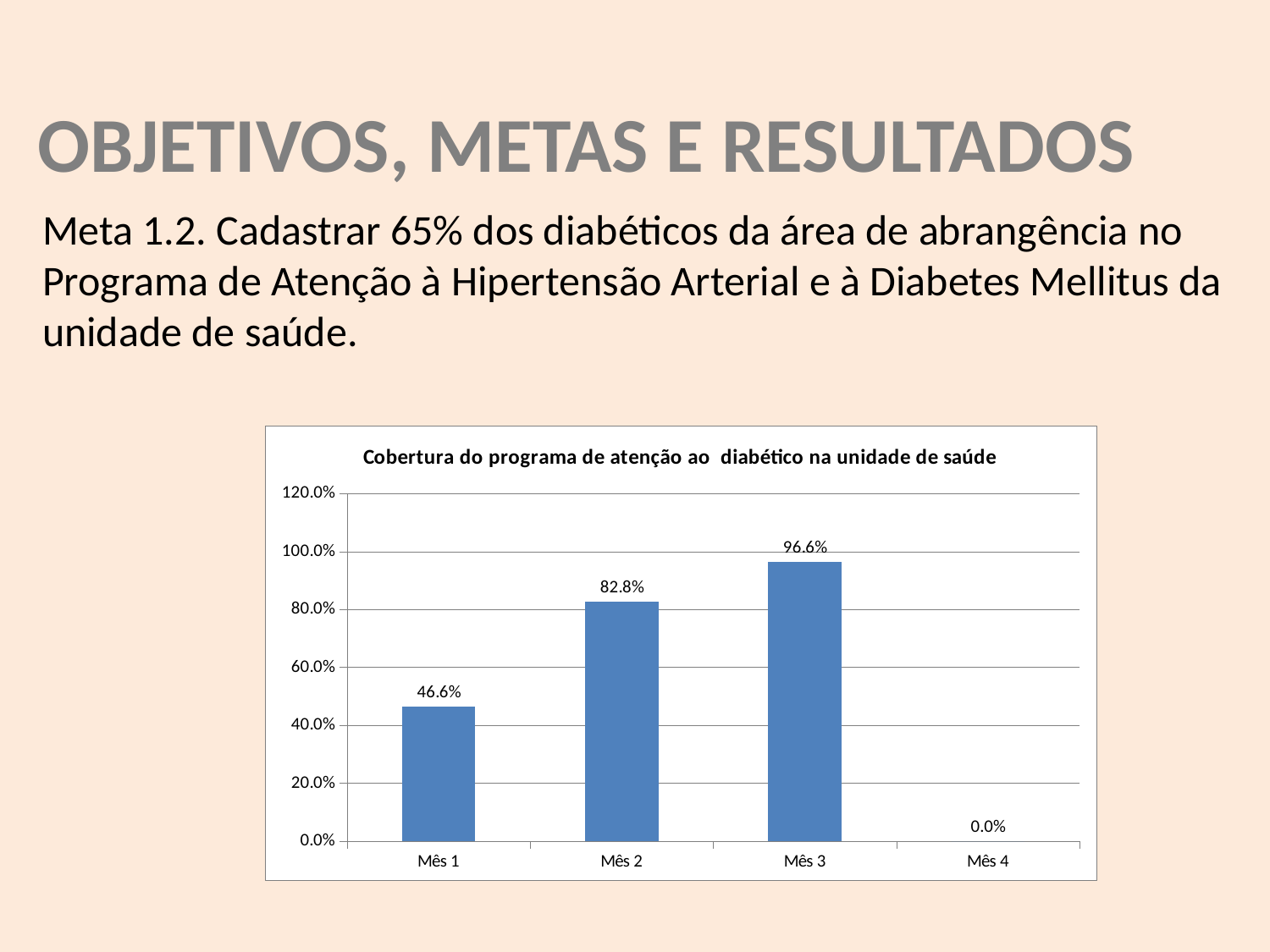
Which month has the lowest value? Mês 4 Which is larger, the value for Mês 1 or the value for Mês 2? Mês 2 What is the value for Mês 2? 82.8% Which month has the highest value? Mês 3 How many months are shown on the x axis? 4 What is the title of the chart? Cobertura do programa de atenção ao diabético na unidade de saúde What is the value for Mês 1? 46.6% What is the value for Mês 4? 0.0% What is the difference between the values for Mês 2 and Mês 1? 36.2% What is the difference between the values for Mês 3 and Mês 2? 13.8% What is the value for Mês 3? 96.6% What kind of chart is shown on the slide? Bar chart